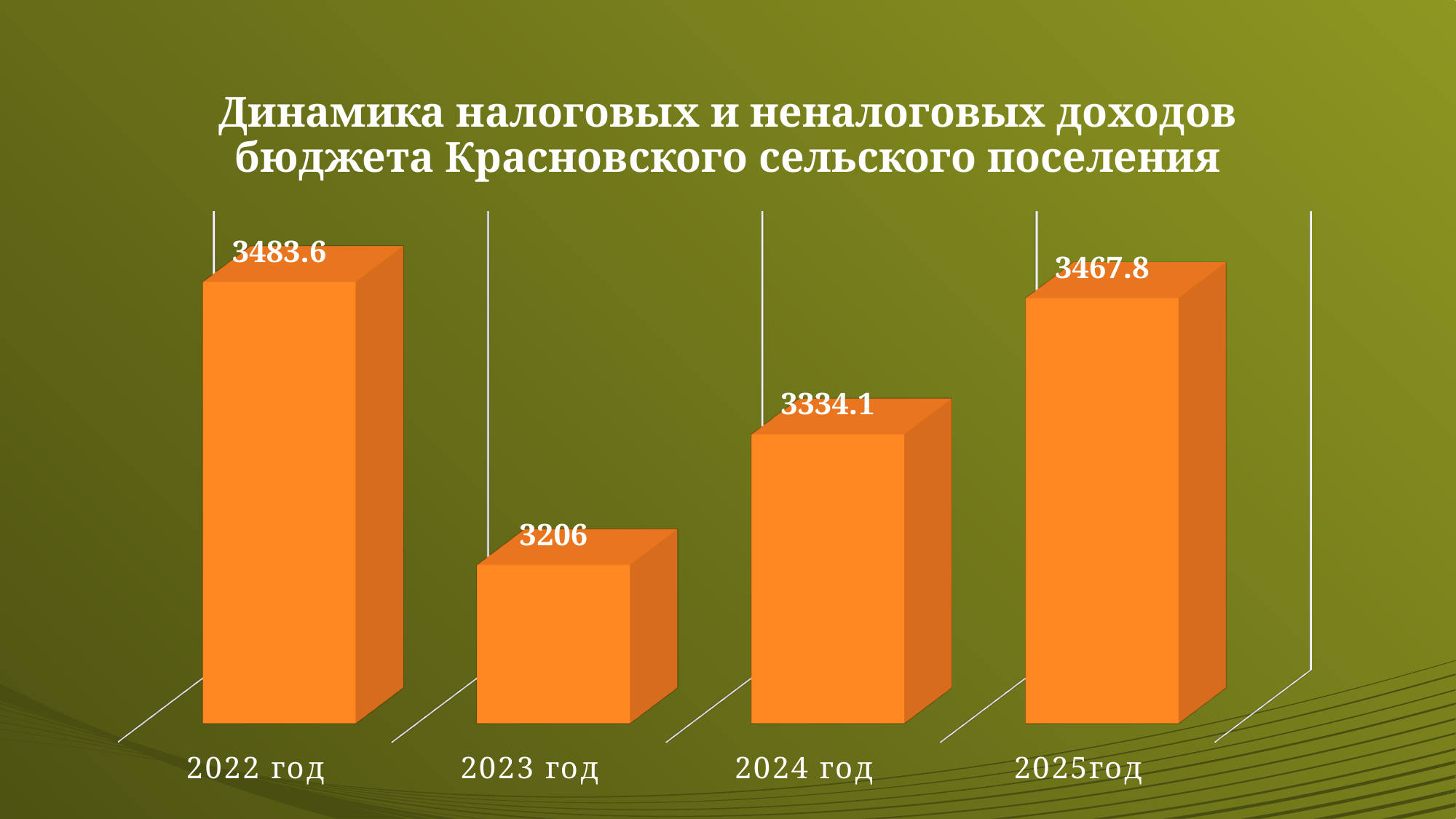
Which year has the lowest value? 2023 год What is the difference between the values for 2025год and 2024 год? 133.7 What is the difference between the values for 2022 год and 2023 год? 277.6 What is the value for 2023 год? 3206 What is the value for 2025год? 3467.8 What is the value for 2024 год? 3334.1 What is the value for 2022 год? 3483.6 How many years are shown in the chart? 4 Which is larger, the value for 2024 год or the value for 2023 год? 2024 год Which year has the highest value? 2022 год What is the title of the chart? Динамика налоговых и неналоговых доходов бюджета Красновского сельского поселения What kind of chart is shown on the slide? bar chart